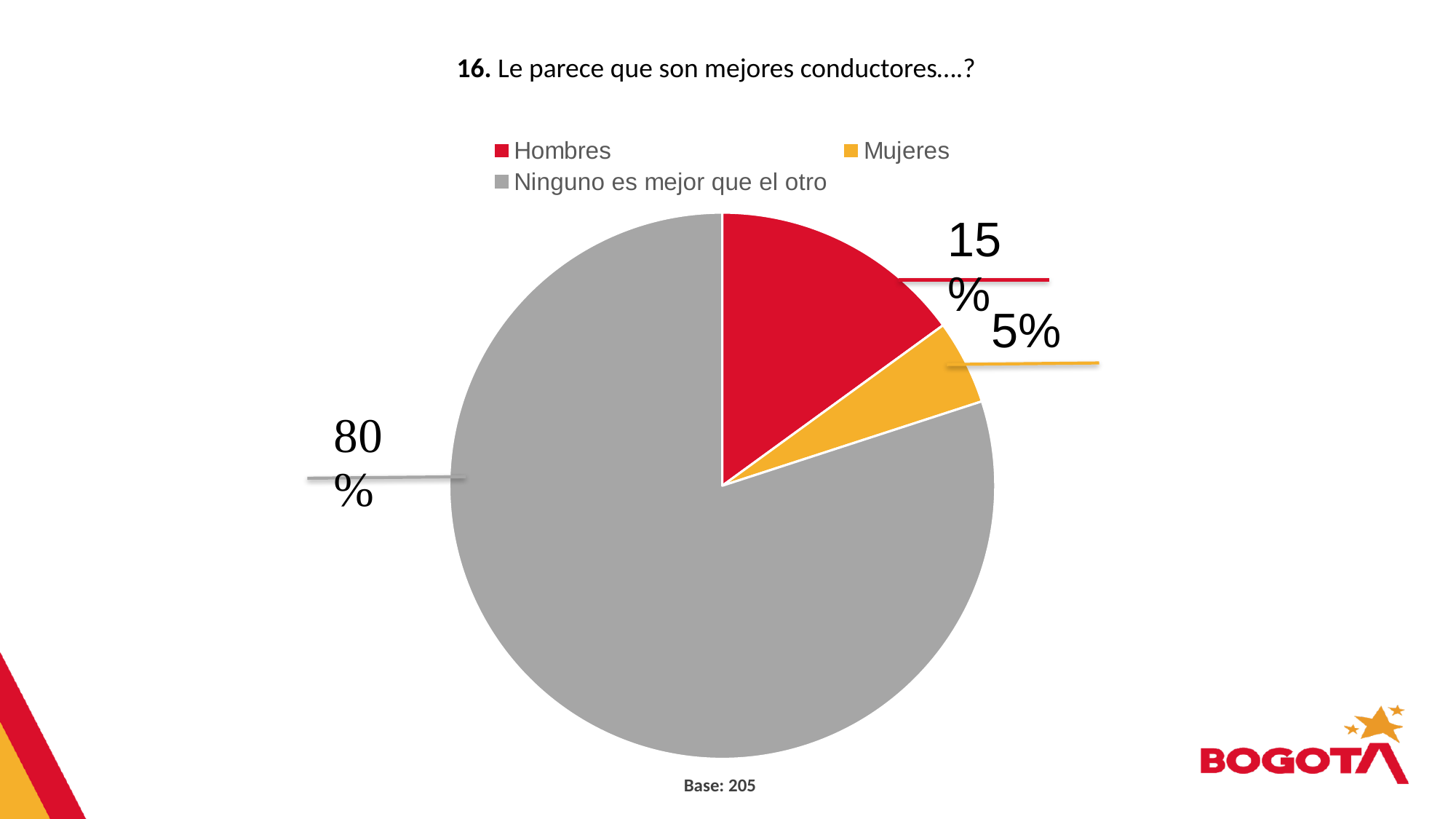
What percentage of respondents answered "Ninguno es mejor que el otro"? 80% How many entries does the legend list? 3 What is the base (number of respondents) shown below the chart? 205 What colour represents "Mujeres" in the pie chart? yellow What kind of chart is shown on the slide? pie chart Which is larger, the share for "Hombres" or the share for "Mujeres"? Hombres What percentage of respondents answered "Mujeres"? 5% How many categories does the pie chart show? 3 Which category has the largest share of the pie? Ninguno es mejor que el otro What percentage of respondents answered "Hombres"? 15% Which category has the smallest share of the pie? Mujeres What is the difference in percentage points between "Hombres" and "Mujeres"? 10